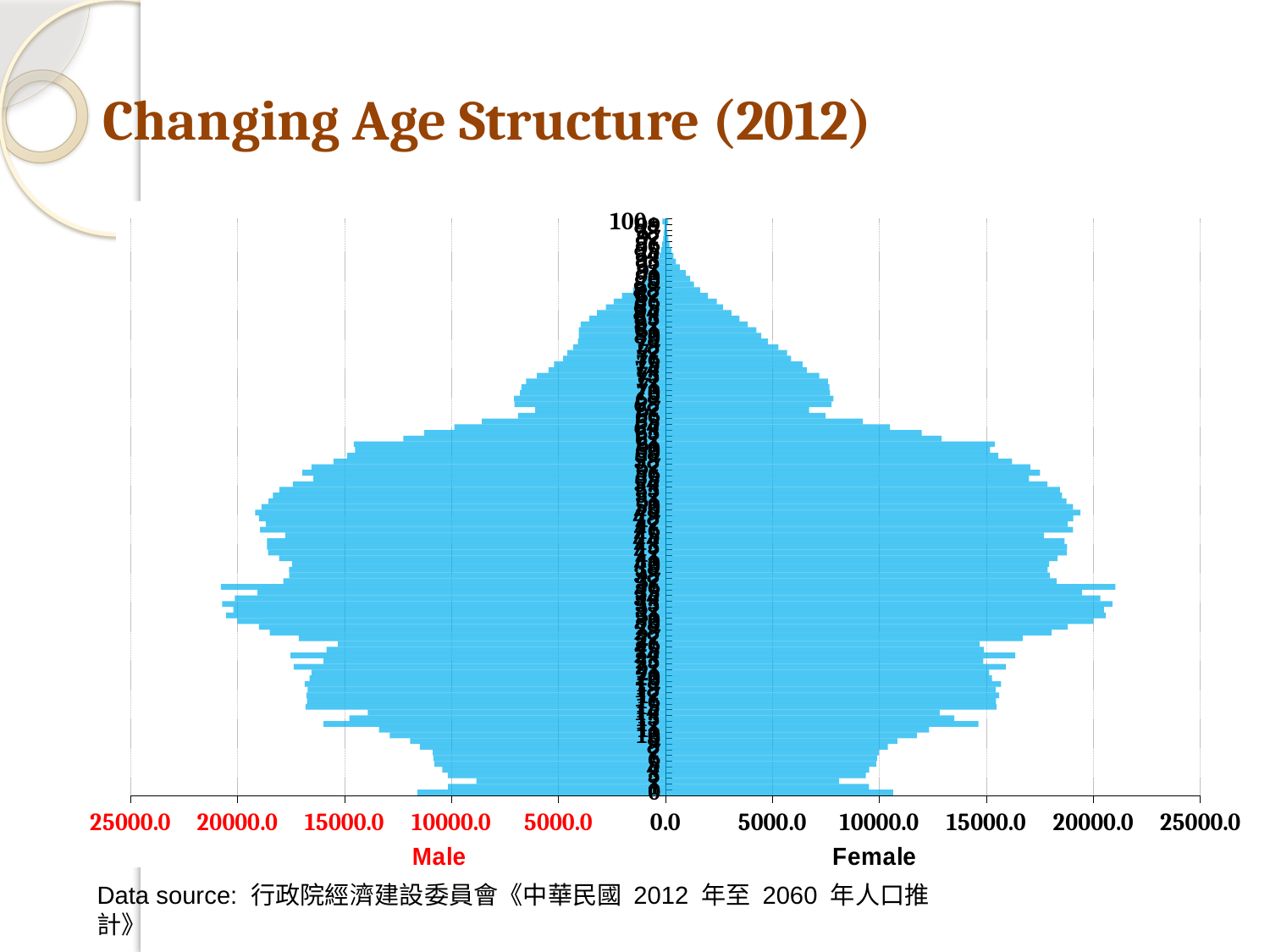
Which group is plotted on the left side of the chart? Male What kind of chart is shown on the slide? bar chart Is the longest Male bar greater or less than 20000.0? greater Are the bars at the oldest ages (near the top of the chart) shorter or longer than the bars in the middle ages? shorter What is the largest value shown on the horizontal axis? 25000.0 How many population groups (sides) are plotted in the chart? 2 What is the title of the chart on the slide? Changing Age Structure (2012) What is the age label at the top of the vertical axis? 100 Is the Male value at age 100 greater or less than 5000.0? less Is the longest Female bar greater or less than 20000.0? greater